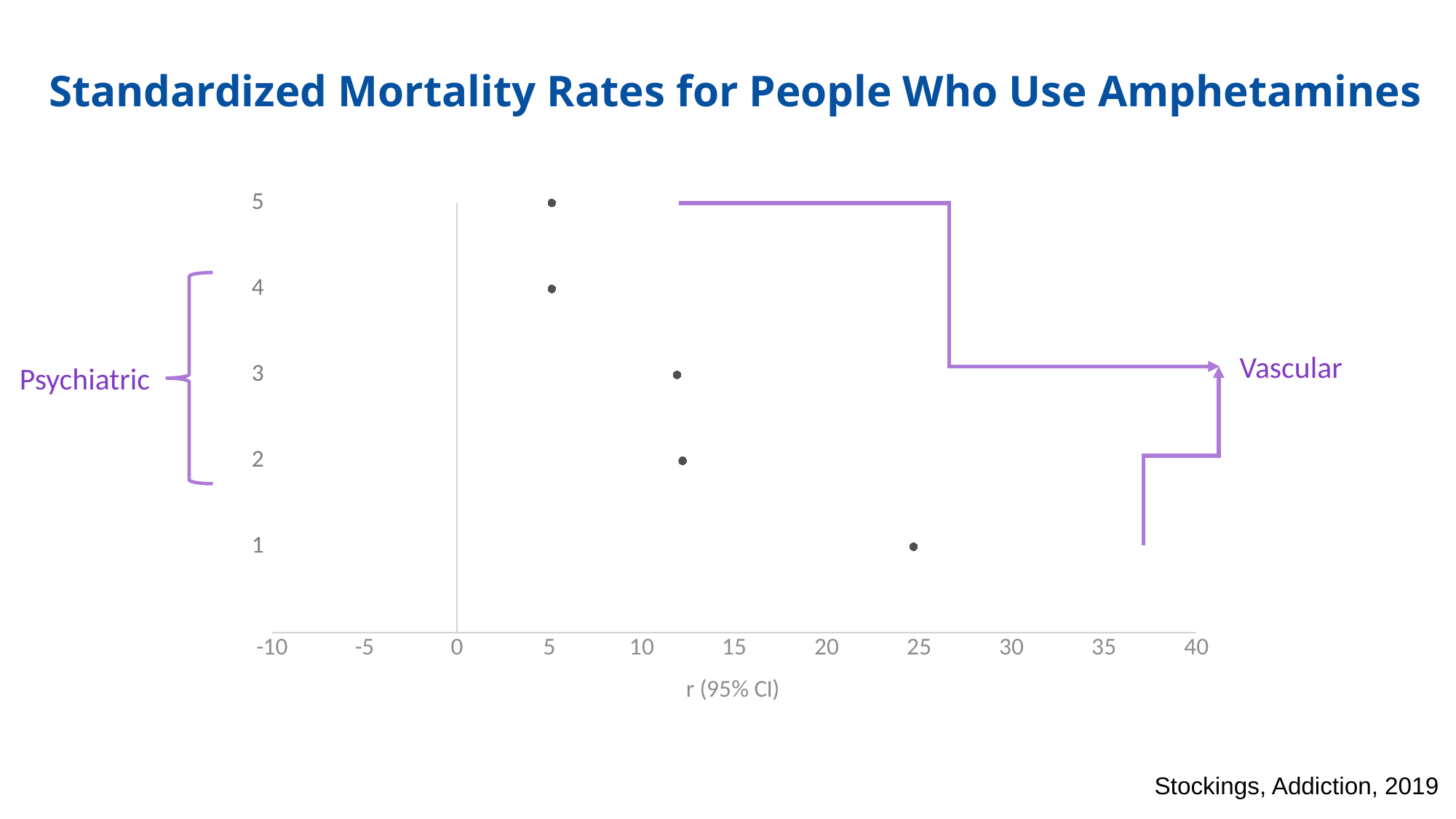
What is the label on the x axis? r (95% CI) Which has a larger r value, category 1 or category 4? category 1 What kind of chart is shown on the slide? scatter plot Which y-axis category has the lowest r value? 4 and 5 (tied) What is the title of the chart? Standardized Mortality Rates for People Who Use Amphetamines Which y-axis category has the highest r value? 1 Is the r value for category 3 greater or less than 10? greater Is the r value for category 5 greater or less than 10? less Which has a larger r value, category 2 or category 5? category 2 Is the r value for category 1 greater or less than 30? less How many data points are plotted on the chart? 5